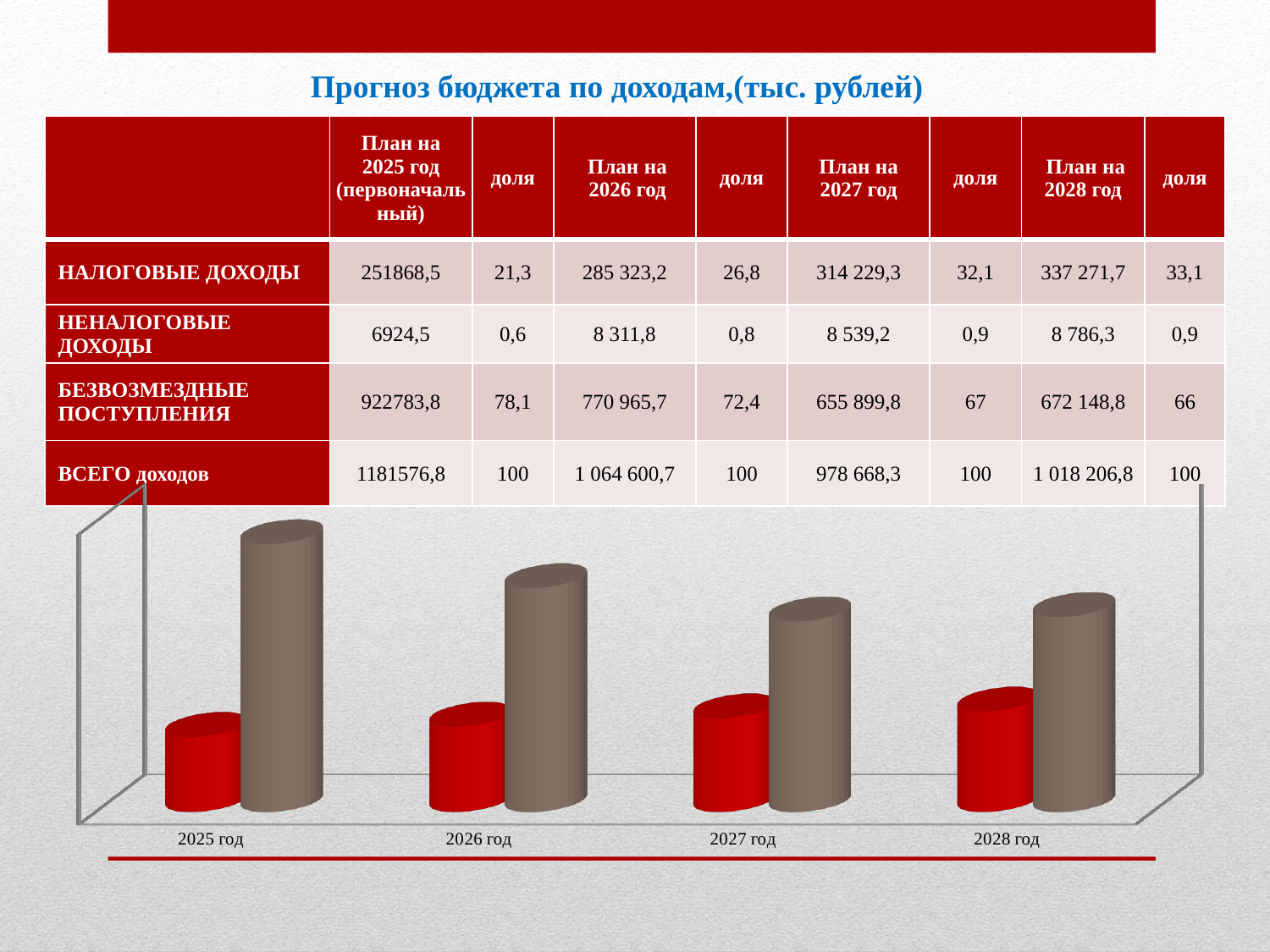
In the chart, is the red bar for 2028 год taller or shorter than the red bar for 2025 год? taller What two colours are used for the bars in the chart? red and grey In the chart, is the grey bar for 2028 год taller or shorter than the grey bar for 2026 год? shorter What kind of chart is shown below the table? bar chart How many year categories are shown on the x axis of the chart? 4 In the chart, is the grey bar for 2026 год taller or shorter than the grey bar for 2027 год? taller In the chart, do the grey bars rise or fall from 2025 год to 2027 год? fall In the chart, do the red bars rise or fall from 2025 год to 2028 год? rise Does the chart display a legend? No In the chart, for which year is the grey bar the tallest? 2025 год